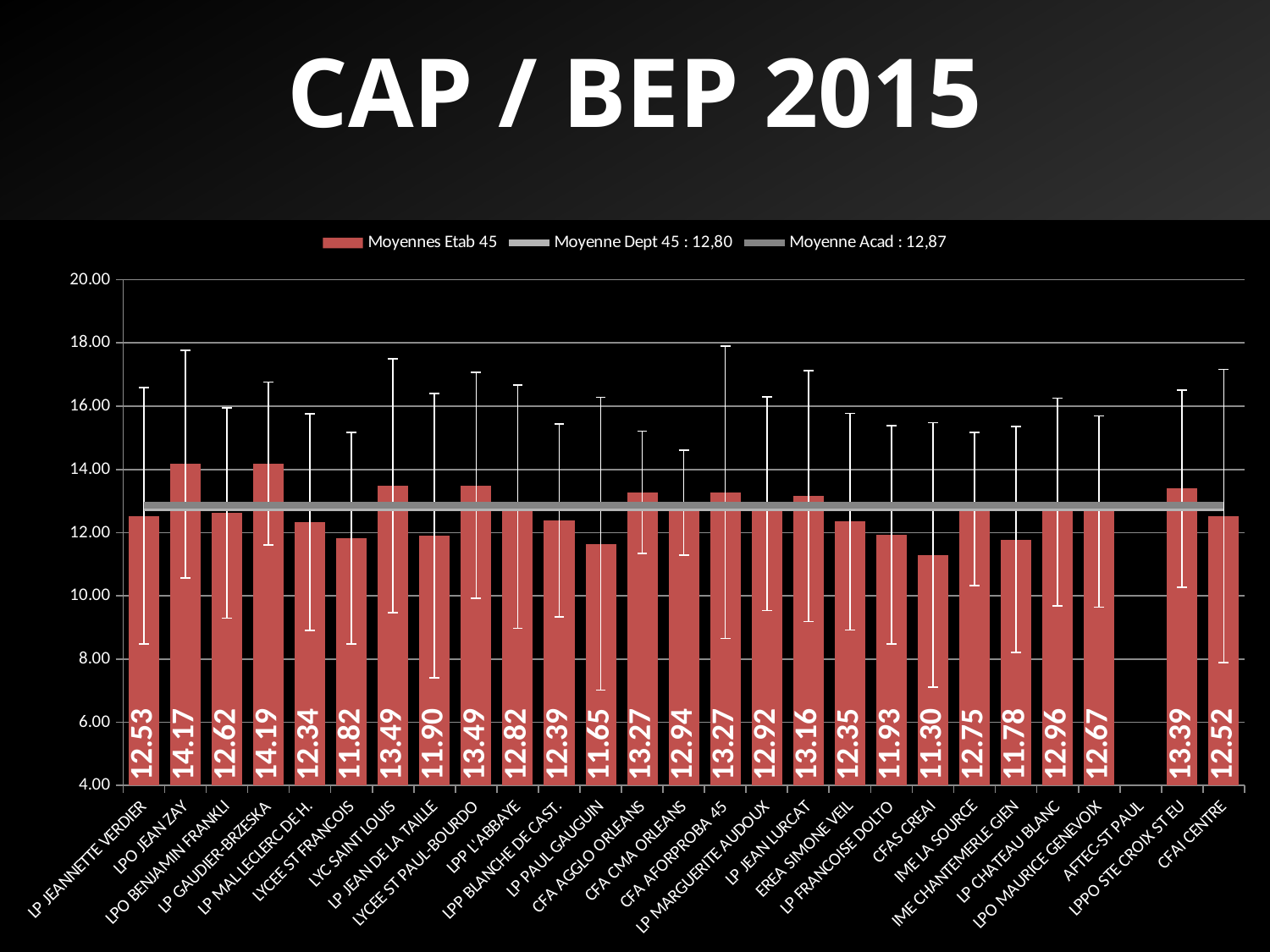
What is the value for LPPO STE CROIX ST EU? 13.39 What value does the legend give for Moyenne Dept 45? 12,80 How many series does the legend list? 3 What is the value for CFAS CREAI? 11.30 What kind of chart is shown on the slide? bar chart What is the value for LPO JEAN ZAY? 14.17 Which category has the lowest value? CFAS CREAI What is the difference between the values for LYC SAINT LOUIS and LP PAUL GAUGUIN? 1.84 How many categories are listed on the x axis? 27 Which is larger, the value for CFA AGGLO ORLEANS or the value for LP JEAN LURCAT? CFA AGGLO ORLEANS Is the value for LP JEAN DE LA TAILLE greater or less than 12.00? less Which category has the highest value? LP GAUDIER-BRZESKA